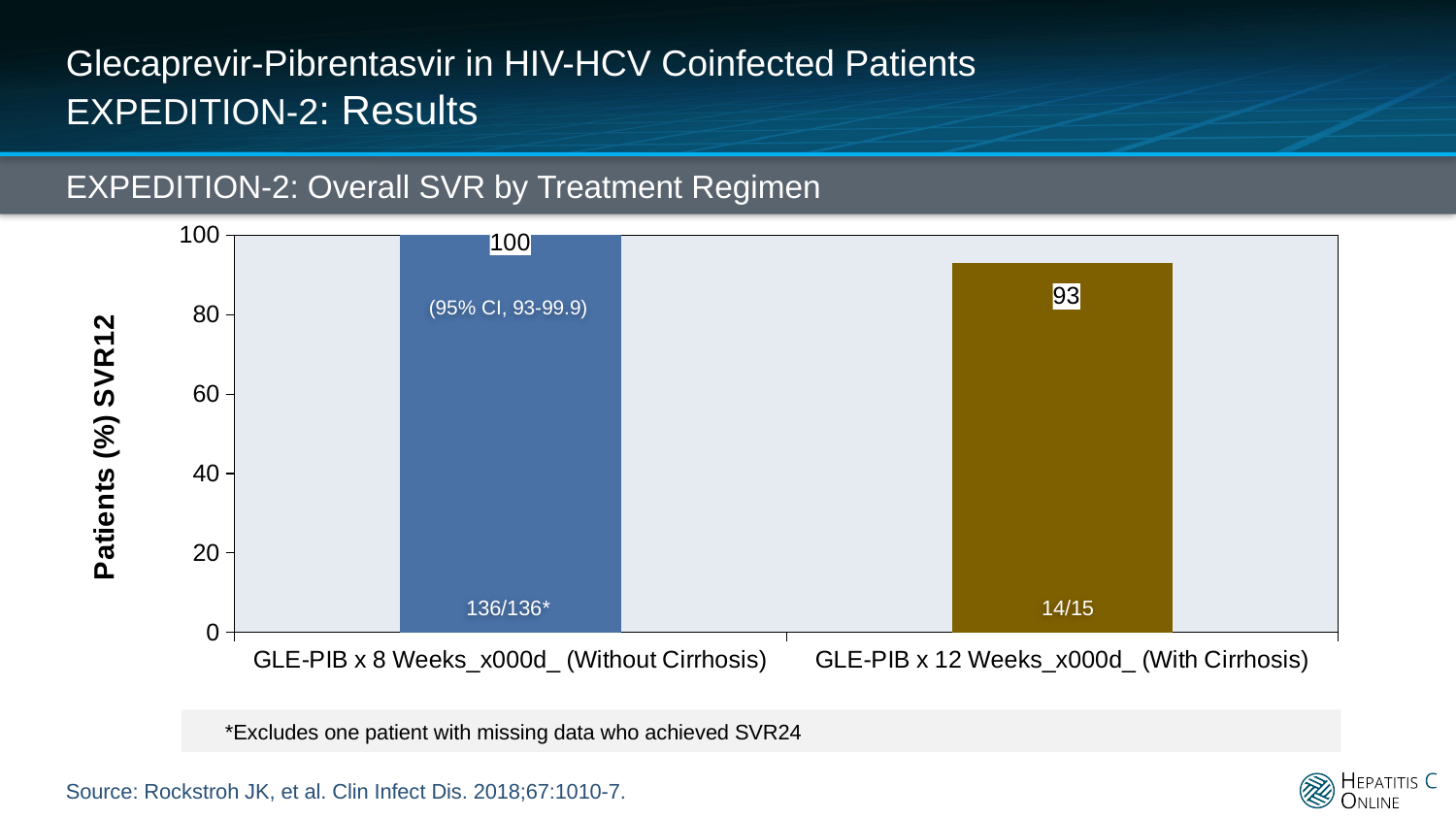
Which treatment regimen has the highest SVR12 value? GLE-PIB x 8 Weeks (Without Cirrhosis) What is the SVR12 value for GLE-PIB x 12 Weeks (With Cirrhosis)? 93 Which has a larger SVR12 value: GLE-PIB x 8 Weeks (Without Cirrhosis) or GLE-PIB x 12 Weeks (With Cirrhosis)? GLE-PIB x 8 Weeks (Without Cirrhosis) Is the value for GLE-PIB x 12 Weeks (With Cirrhosis) greater or less than 80? greater What is the difference in SVR12 between GLE-PIB x 8 Weeks (Without Cirrhosis) and GLE-PIB x 12 Weeks (With Cirrhosis)? 7 What patient fraction is printed on the bar for GLE-PIB x 8 Weeks (Without Cirrhosis)? 136/136* Which treatment regimen has the lowest SVR12 value? GLE-PIB x 12 Weeks (With Cirrhosis) What is the SVR12 value for GLE-PIB x 8 Weeks (Without Cirrhosis)? 100 What kind of chart is shown on the slide? bar chart What is the title of the chart? EXPEDITION-2: Overall SVR by Treatment Regimen How many treatment regimens are shown in the chart? 2 What patient fraction is printed on the bar for GLE-PIB x 12 Weeks (With Cirrhosis)? 14/15